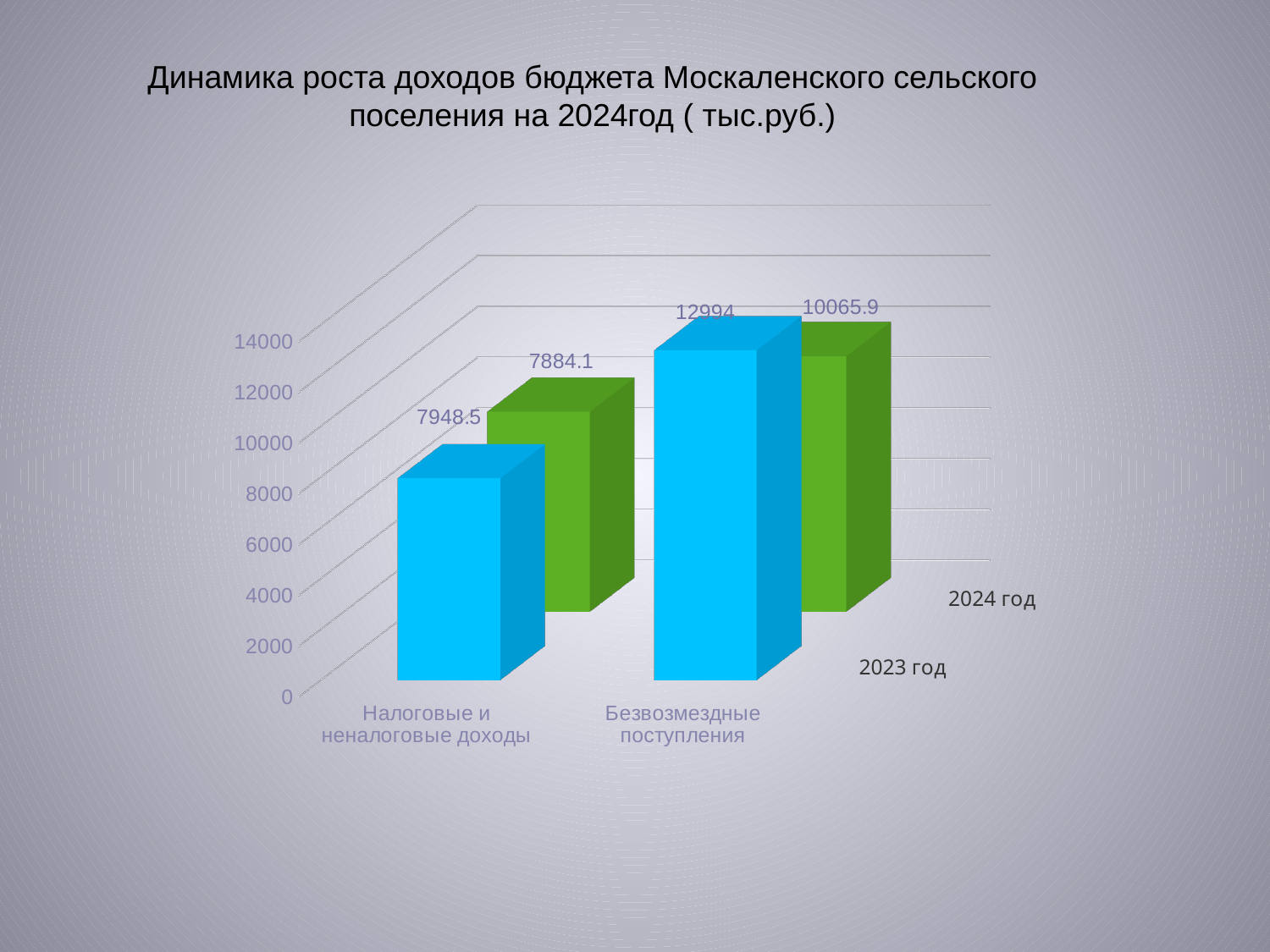
What is the value for Безвозмездные поступления in 2024 год? 10065.9 What is the value for Налоговые и неналоговые доходы in 2023 год? 7948.5 Which category has the highest value in 2023 год? Безвозмездные поступления What kind of chart is shown on the slide? bar chart What is the value for Налоговые и неналоговые доходы in 2024 год? 7884.1 Which category has the lowest value in 2024 год? Налоговые и неналоговые доходы What is the value for Безвозмездные поступления in 2023 год? 12994 What is the difference between the 2023 год and 2024 год values for Безвозмездные поступления? 2928.1 Which is larger for Безвозмездные поступления: the 2023 год value or the 2024 год value? 2023 год Is the value for Безвозмездные поступления in 2023 год greater or less than 12000? greater How many series does the chart show? 2 How many categories are shown on the x axis? 2